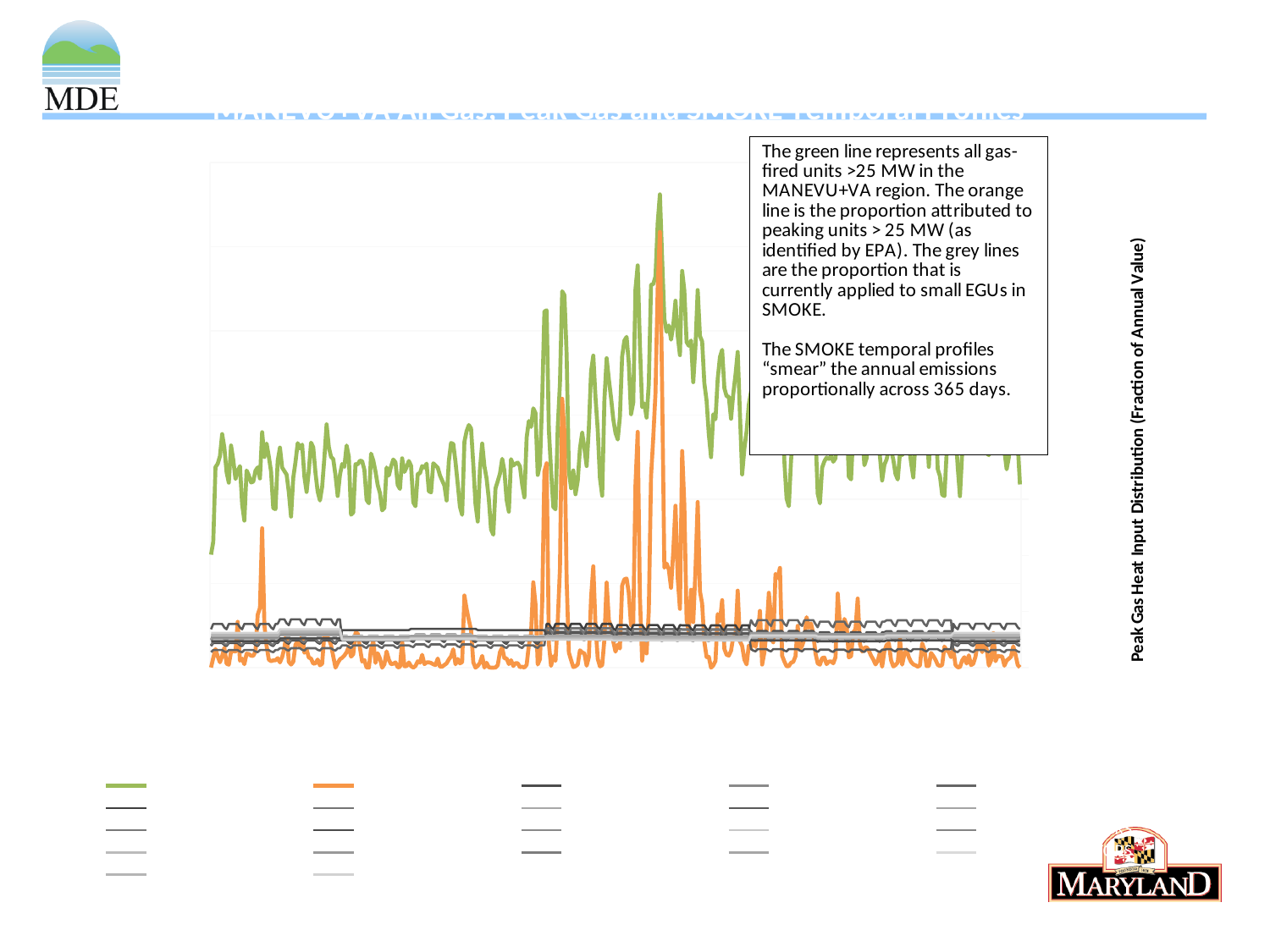
Which lines stay lowest and flattest across the chart, the green, orange or grey lines? the grey lines What is the axis title printed vertically on the right side of the chart? Peak Gas Heat Input Distribution (Fraction of Annual Value) What kind of chart is shown on the slide? line chart Are the grey lines generally above or below the green line? below Which coloured line reaches the highest point on the chart? the green line According to the text box, what does the green line represent? all gas-fired units >25 MW in the MANEVU+VA region